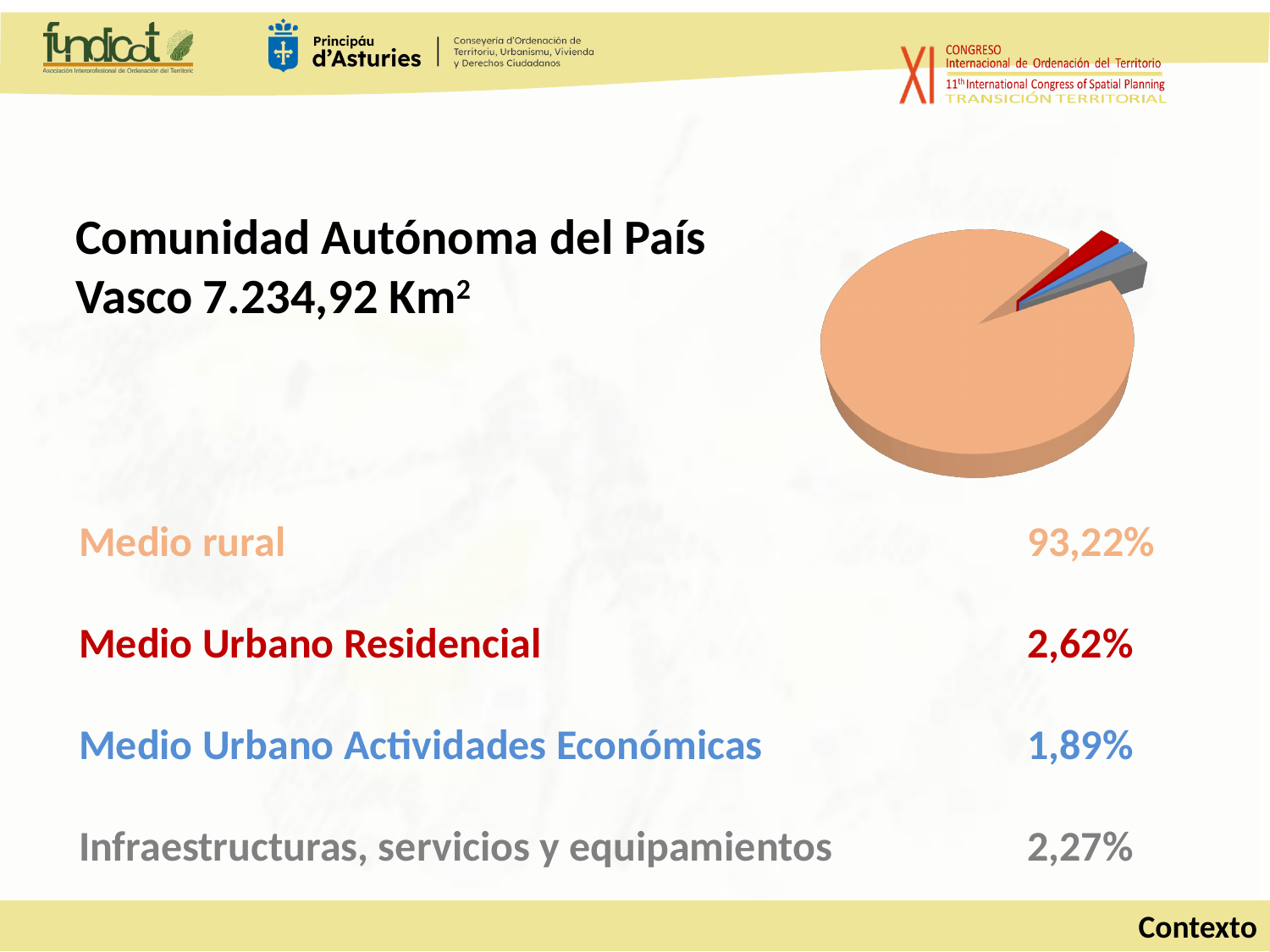
What is the difference between Infraestructuras, servicios y equipamientos and Medio Urbano Actividades Económicas? 0,38% Which category has the largest share of the pie? Medio rural What share of the pie does Medio rural represent? 93,22% Which is larger, Medio Urbano Residencial or Infraestructuras, servicios y equipamientos? Medio Urbano Residencial Which category has the smallest share of the pie? Medio Urbano Actividades Económicas What colour is the slice for Medio rural in the pie chart? orange What kind of chart is shown on the slide? pie chart What is the value for Medio Urbano Residencial? 2,62% What is the value for Medio Urbano Actividades Económicas? 1,89% What is the difference between Medio Urbano Residencial and Medio Urbano Actividades Económicas? 0,73% What is the value for Infraestructuras, servicios y equipamientos? 2,27% How many slices does the pie chart have? 4